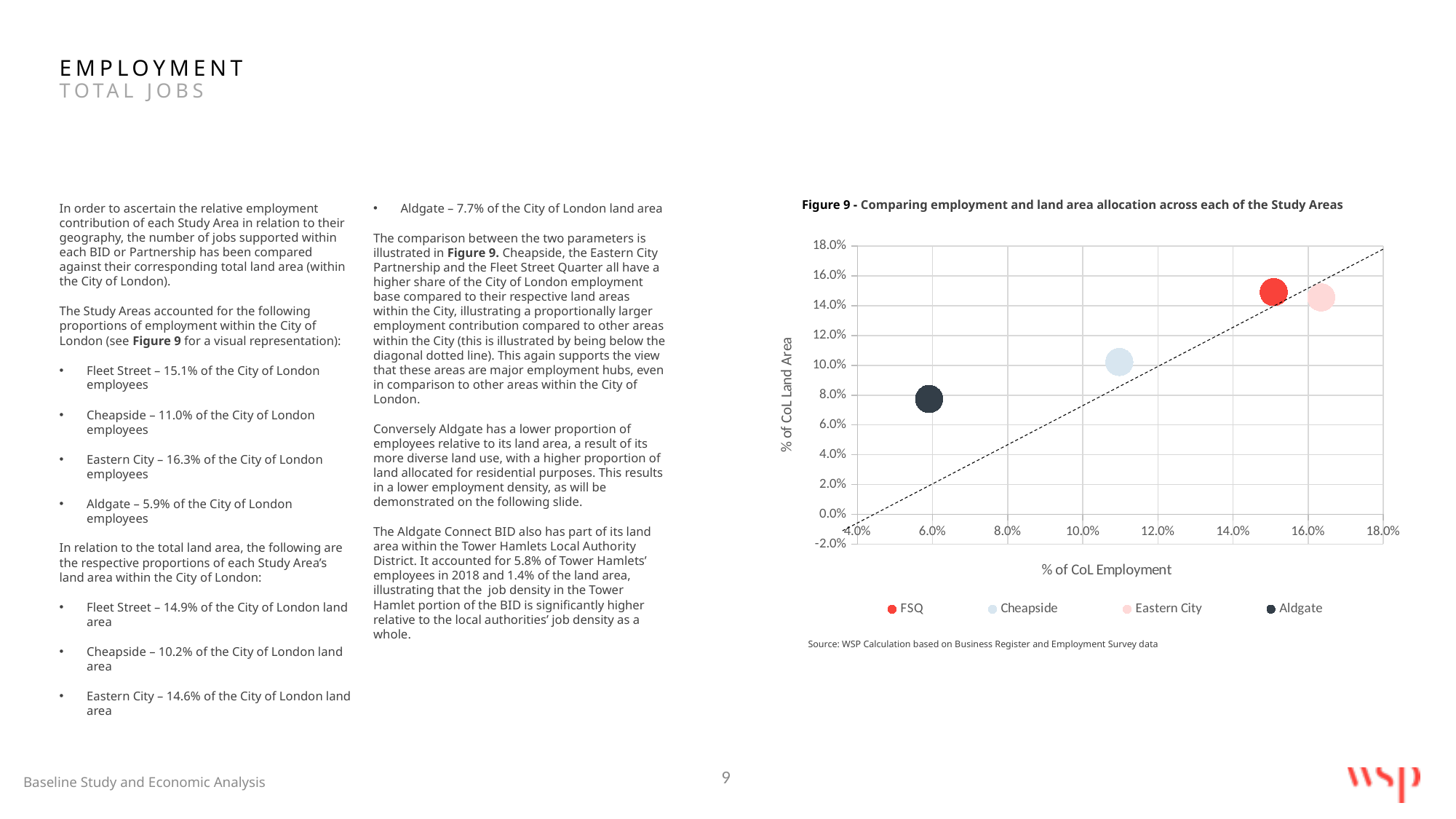
How many data points are plotted in Figure 9? 4 In Figure 9, is the % of CoL Employment for Aldgate greater or less than 8.0%? less In Figure 9, which has a higher % of CoL Employment, Cheapside or Aldgate? Cheapside In Figure 9, is the % of CoL Land Area for FSQ greater or less than 12.0%? greater In Figure 9, which study area has the lowest % of CoL Land Area? Aldgate In Figure 9, which study area has the lowest % of CoL Employment? Aldgate What is the label of the horizontal axis in Figure 9? % of CoL Employment What kind of chart is Figure 9? Scatter chart In Figure 9, is the % of CoL Employment for Eastern City greater or less than 14.0%? greater In Figure 9, which study area has the highest % of CoL Employment? Eastern City How many series does the legend of Figure 9 list? 4